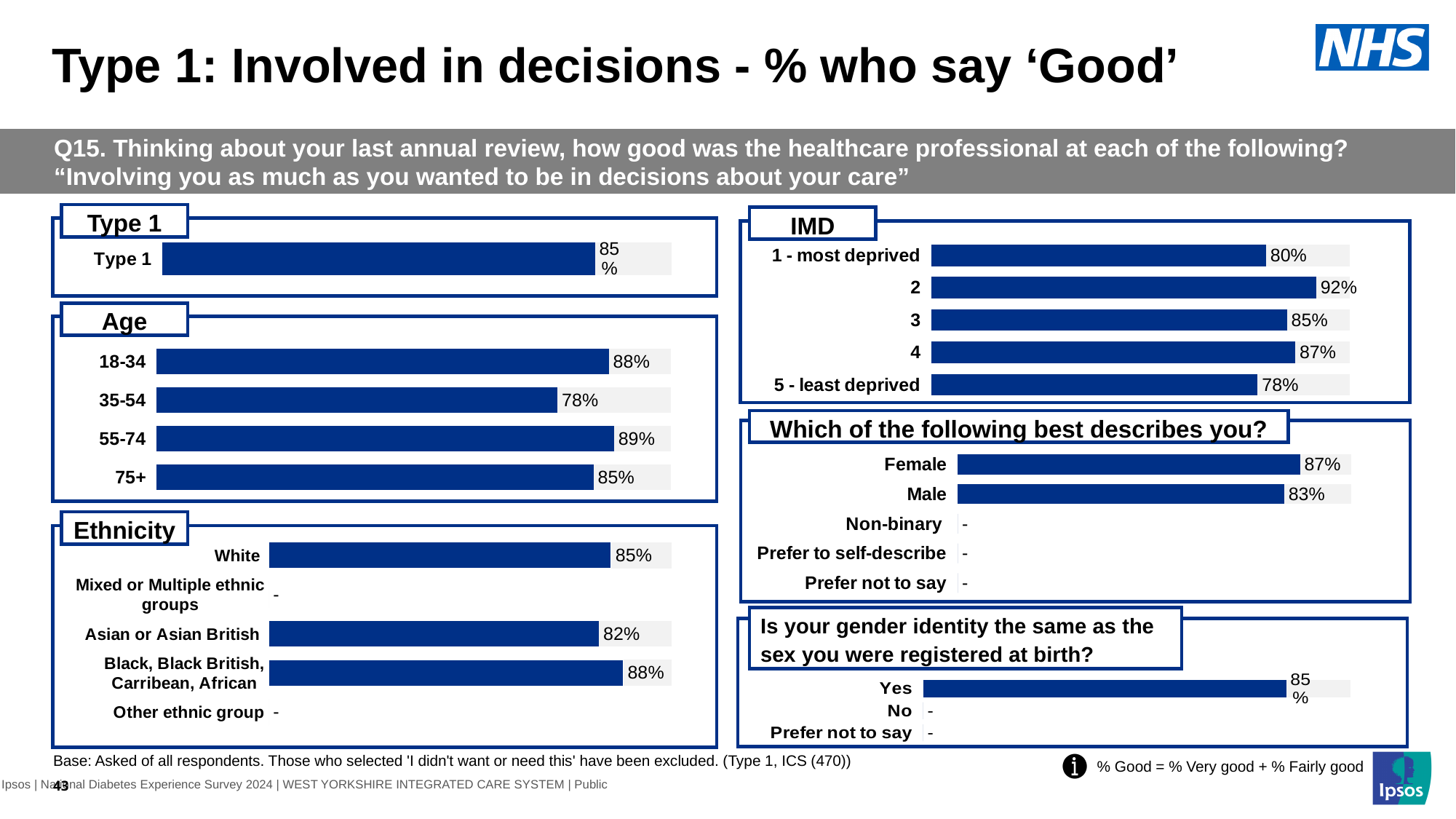
How many categories are listed in the IMD chart? 5 In the Age chart, what is the difference between the values for 55-74 and 35-54? 11 percentage points In the Age chart, what is the value for 35-54? 78% In the IMD chart, which category has the lowest value? 5 - least deprived In the IMD chart, which category has the highest value? 2 In the Ethnicity chart, what is the value for Asian or Asian British? 82% In the Ethnicity chart, which category has the highest value? Black, Black British, Carribean, African In the IMD chart, what is the difference between the values for 2 and 1 - most deprived? 12 percentage points In the 'Is your gender identity the same as the sex you were registered at birth?' chart, what is the value for Yes? 85% In the Type 1 chart, what is the value for Type 1? 85% In the 'Which of the following best describes you?' chart, which is larger, Female or Male? Female What kind of chart is the Age chart? Bar chart